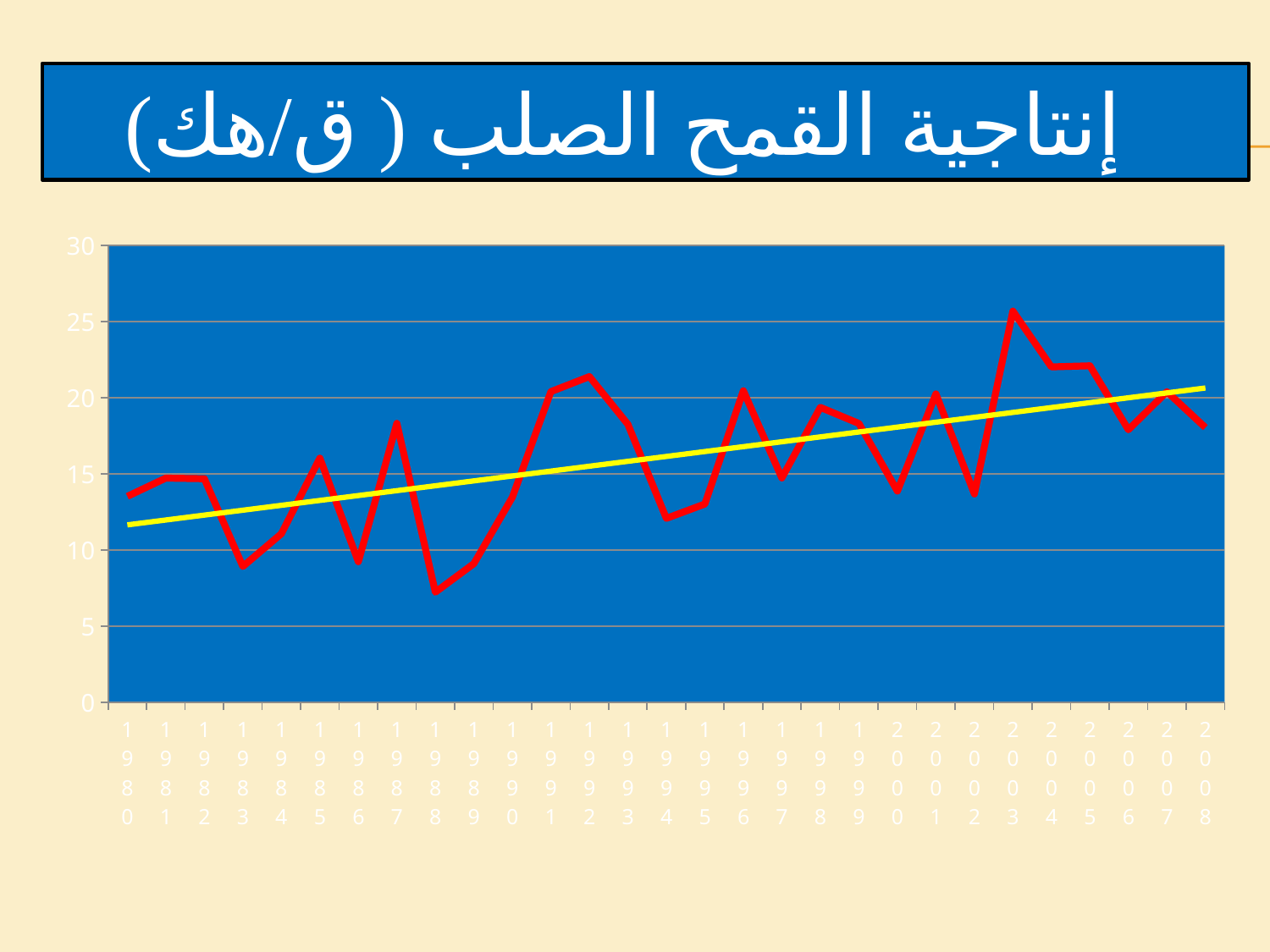
What kind of chart is shown on the slide? line chart How many years (data points) are plotted along the x axis? 29 Which year has the highest value on the red line? 2003 Which year has the lowest value on the red line? 1988 Is the value for 2008 greater or less than 20? less What is the title of the chart on the slide? إنتاجية القمح الصلب ( ق/هك) Is the value for 2003 greater or less than 25? greater Is the value for 1988 greater or less than 10? less Which year has the larger value, 1983 or 1992? 1992 Does the yellow trend line rise or fall from 1980 to 2008? rise